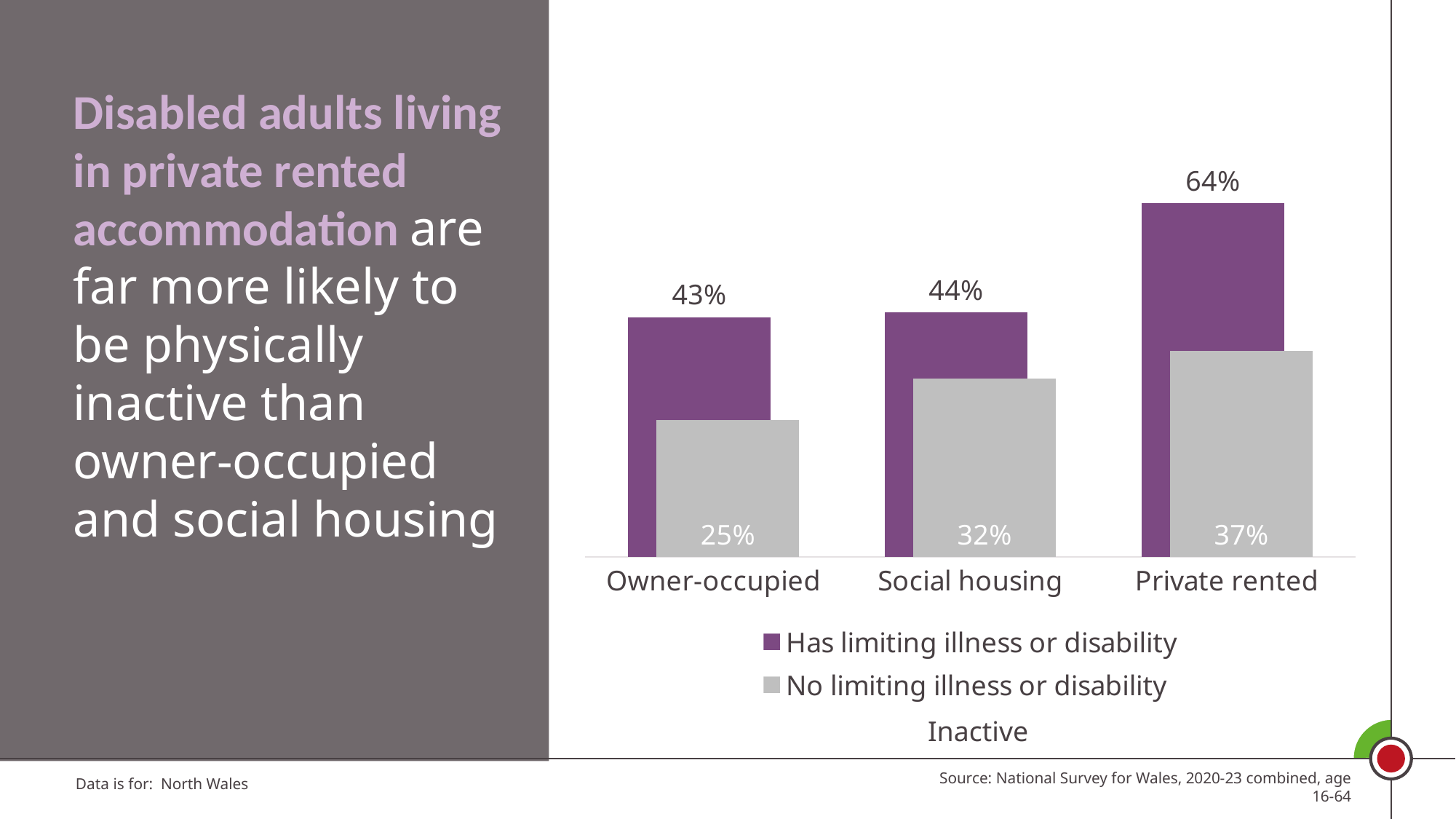
Which category has the lowest value for 'No limiting illness or disability'? Owner-occupied Which is larger: the 'Has limiting illness or disability' value for Private rented or for Owner-occupied? Private rented What is the difference between the 'Has limiting illness or disability' and 'No limiting illness or disability' values in the Private rented category? 27% What kind of chart is shown on the slide? Bar chart How many series does the legend list? 2 Which category has the highest value for 'Has limiting illness or disability'? Private rented What is the difference between the 'No limiting illness or disability' values for Social housing and Owner-occupied? 7% How many housing categories are shown on the x axis? 3 What is the value for 'No limiting illness or disability' in the Private rented category? 37% What is the value for 'Has limiting illness or disability' in the Private rented category? 64% What is the value for 'No limiting illness or disability' in the Owner-occupied category? 25% What is the value for 'Has limiting illness or disability' in the Social housing category? 44%